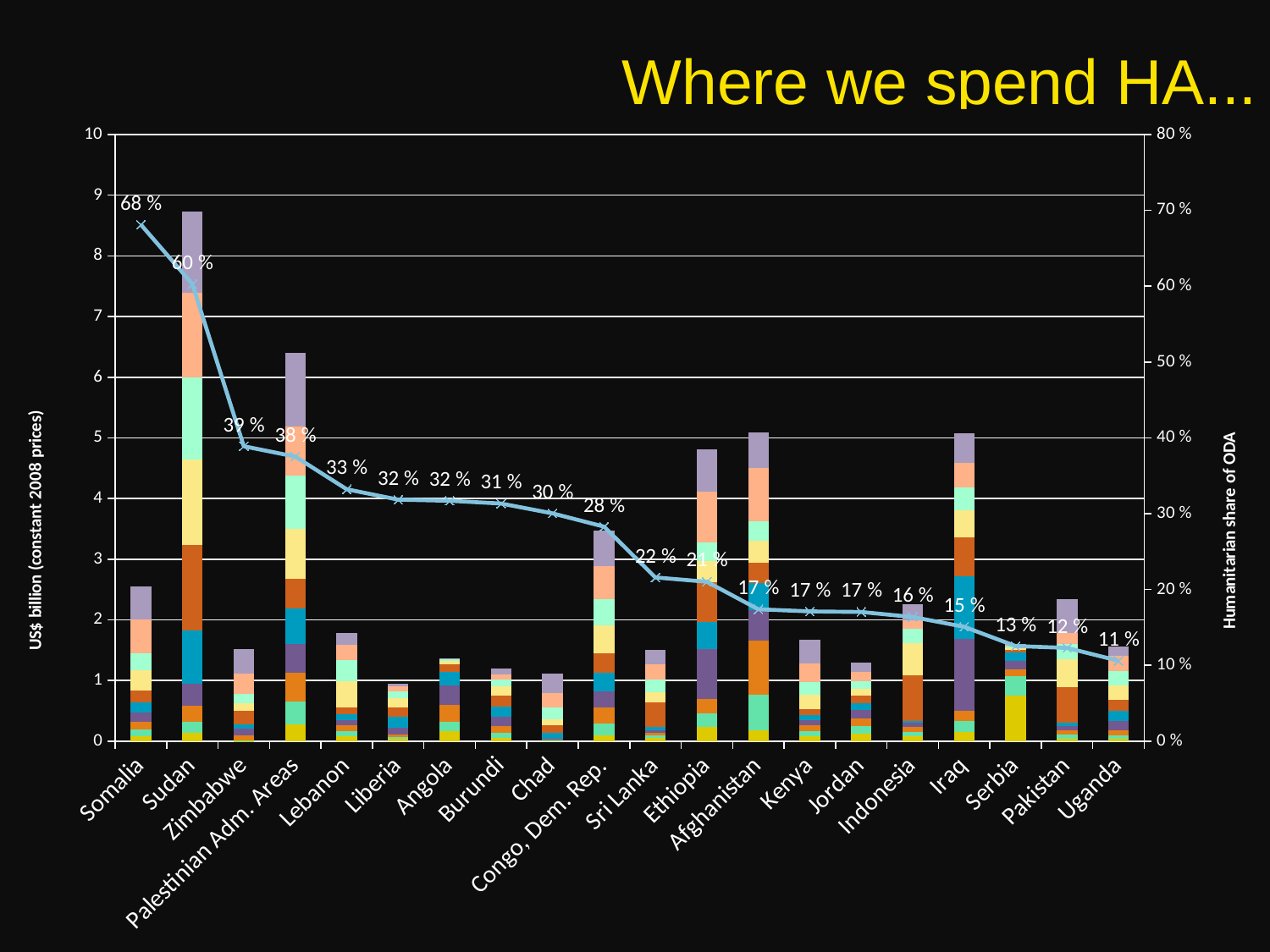
Is the total stacked bar value for Sudan greater or less than 8 US$ billion? greater Which country has the tallest stacked bar (US$ billion)? Sudan How many countries/areas are shown on the x axis? 20 What is the humanitarian share of ODA shown for Sudan? 60 % Which country has the highest humanitarian share of ODA on the line? Somalia Which country has the lowest humanitarian share of ODA on the line? Uganda Does the humanitarian share of ODA line rise or fall from left to right across the x axis? fall What is the humanitarian share of ODA shown for Afghanistan? 17 % Which has the larger humanitarian share of ODA, Zimbabwe or Palestinian Adm. Areas? Zimbabwe What is the humanitarian share of ODA shown for Somalia? 68 % What is the difference in humanitarian share of ODA between Somalia and Sudan? 8 % What is the humanitarian share of ODA shown for Uganda? 11 %